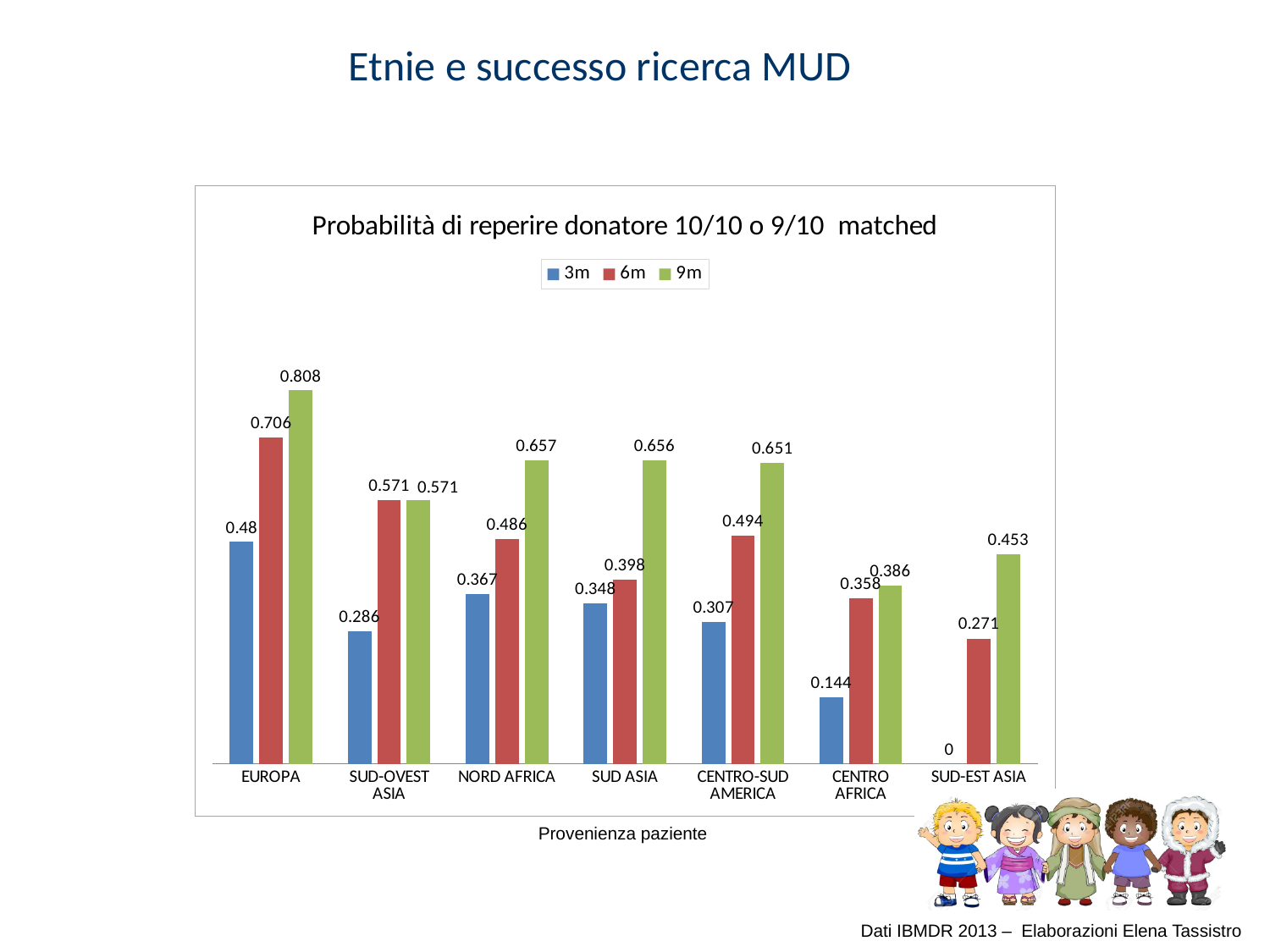
Which category has the lowest 3m value? SUD-EST ASIA What is the difference between the 9m and 3m values for EUROPA? 0.328 Which is larger, the 6m value for NORD AFRICA or the 6m value for CENTRO-SUD AMERICA? CENTRO-SUD AMERICA What is the 6m value for SUD-EST ASIA? 0.271 What kind of chart is shown? bar chart What is the 9m value for EUROPA? 0.808 What is the title of the chart? Probabilità di reperire donatore 10/10 o 9/10 matched How many series does the legend list? 3 How many categories are shown on the x axis? 7 What is the difference between the 6m and 3m values for SUD-OVEST ASIA? 0.285 What is the 3m value for CENTRO AFRICA? 0.144 Which category has the highest 9m value? EUROPA